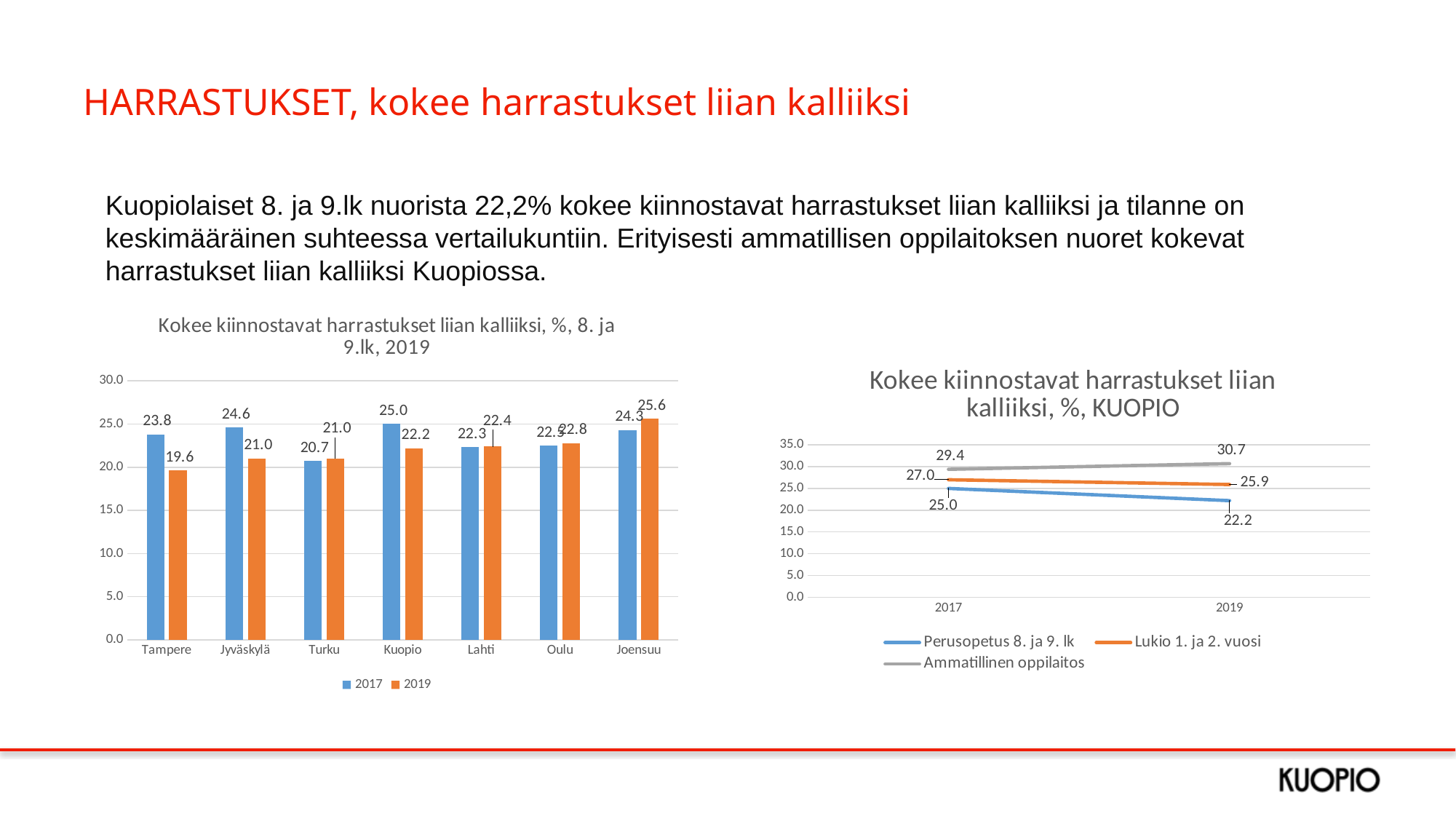
In the left chart (8. ja 9.lk, 2019), is the 2019 value for Turku or for Kuopio larger? Kuopio In the left chart (8. ja 9.lk, 2019), how many series does the legend list? 2 What kind of chart is the right chart (KUOPIO)? Line chart In the right chart (KUOPIO), does the Perusopetus 8. ja 9. lk line rise or fall from 2017 to 2019? Fall In the left chart (8. ja 9.lk, 2019), which city has the highest 2019 value? Joensuu In the left chart (8. ja 9.lk, 2019), what is the 2019 value for Tampere? 19.6 In the right chart (KUOPIO), what is the difference between the 2017 and 2019 values for Lukio 1. ja 2. vuosi? 1.1 In the left chart (8. ja 9.lk, 2019), what is the difference between the 2017 and 2019 values for Jyväskylä? 3.6 In the right chart (KUOPIO), what is the 2019 value for Ammatillinen oppilaitos? 30.7 In the left chart (8. ja 9.lk, 2019), how many cities are shown on the x axis? 7 In the left chart (8. ja 9.lk, 2019), what is the 2017 value for Kuopio? 25.0 In the left chart (8. ja 9.lk, 2019), which city has the lowest 2019 value? Tampere